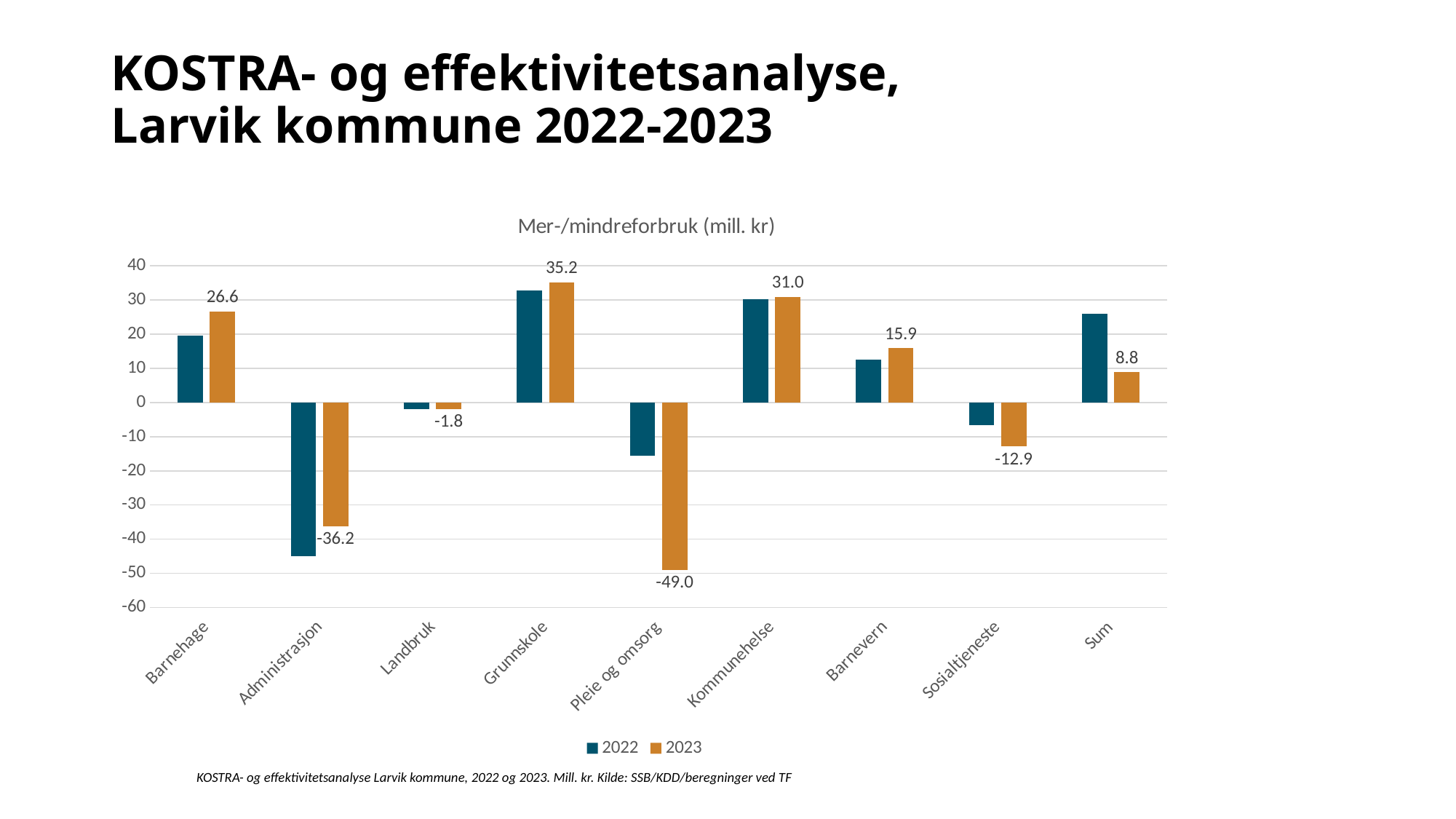
What is the difference between the 2023 values for Grunnskole and Kommunehelse? 4.2 Is the 2022 value for Administrasjon greater or less than -40? less How many categories are shown on the x axis? 9 Which category has the lowest 2023 value? Pleie og omsorg Which category has the highest 2023 value? Grunnskole What is the 2023 value for Barnehage? 26.6 What type of chart is shown on the slide? Bar chart Is the 2022 value for Sum greater or less than 20? greater How many series does the legend list? 2 Which is larger for 2023: Barnevern or Sum? Barnevern What is the 2023 value for Pleie og omsorg? -49.0 What is the 2023 value for Sum? 8.8